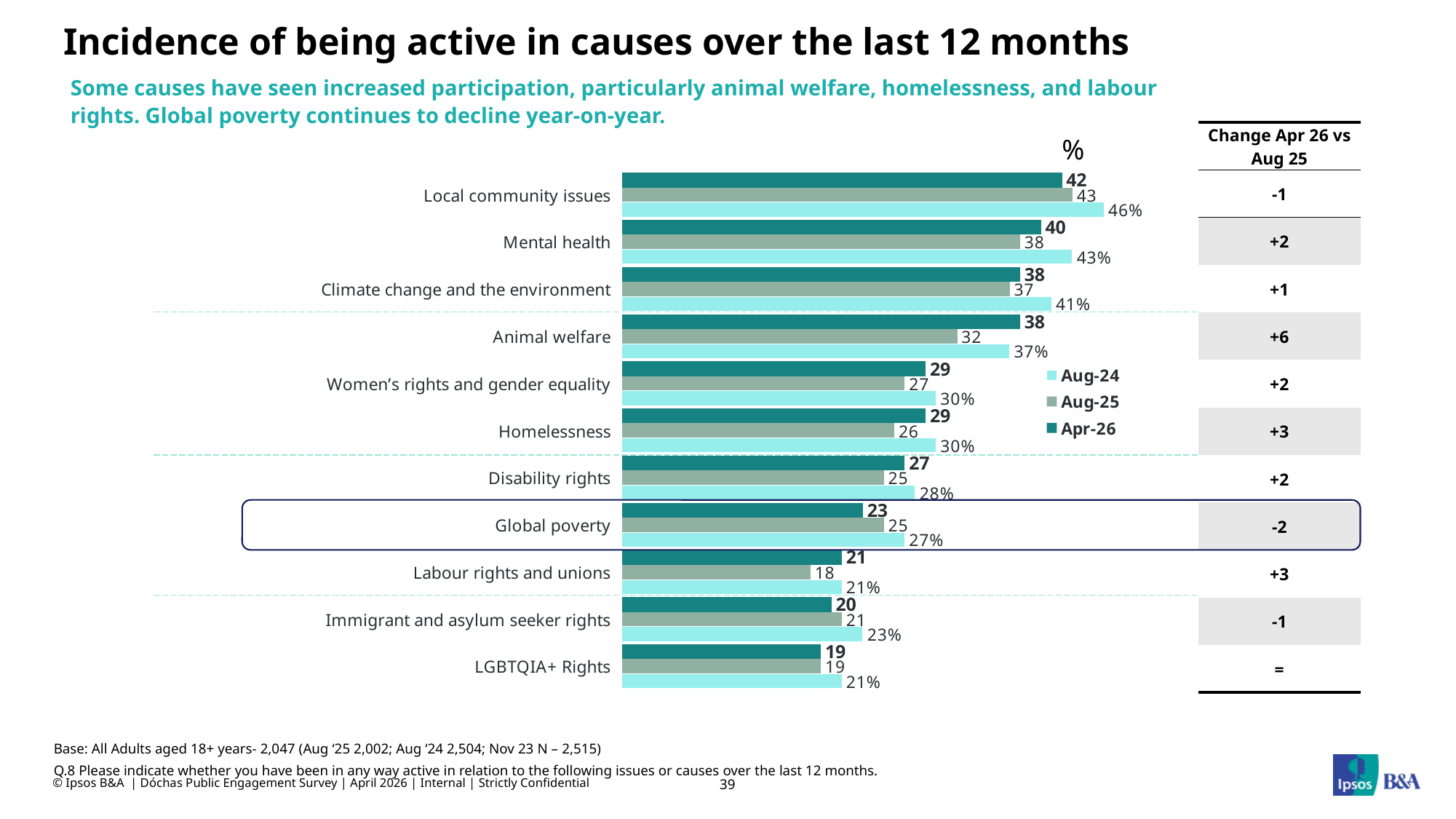
What is the Aug-25 value for Homelessness? 26 How many causes are shown in the chart? 11 How many series does the legend list? 3 What is the Aug-24 value for Local community issues? 46% Which series is shown in the lightest colour in the legend? Aug-24 What is the Apr-26 value for Animal welfare? 38 What is the difference between the Apr-26 and Aug-25 values for Animal welfare? 6 Which cause has the lowest Apr-26 value? LGBTQIA+ Rights Which is larger for Labour rights and unions: the Apr-26 value or the Aug-25 value? Apr-26 What kind of chart is shown on the slide? Bar chart Which cause has the highest Apr-26 value? Local community issues What is the Aug-25 value for Global poverty? 25